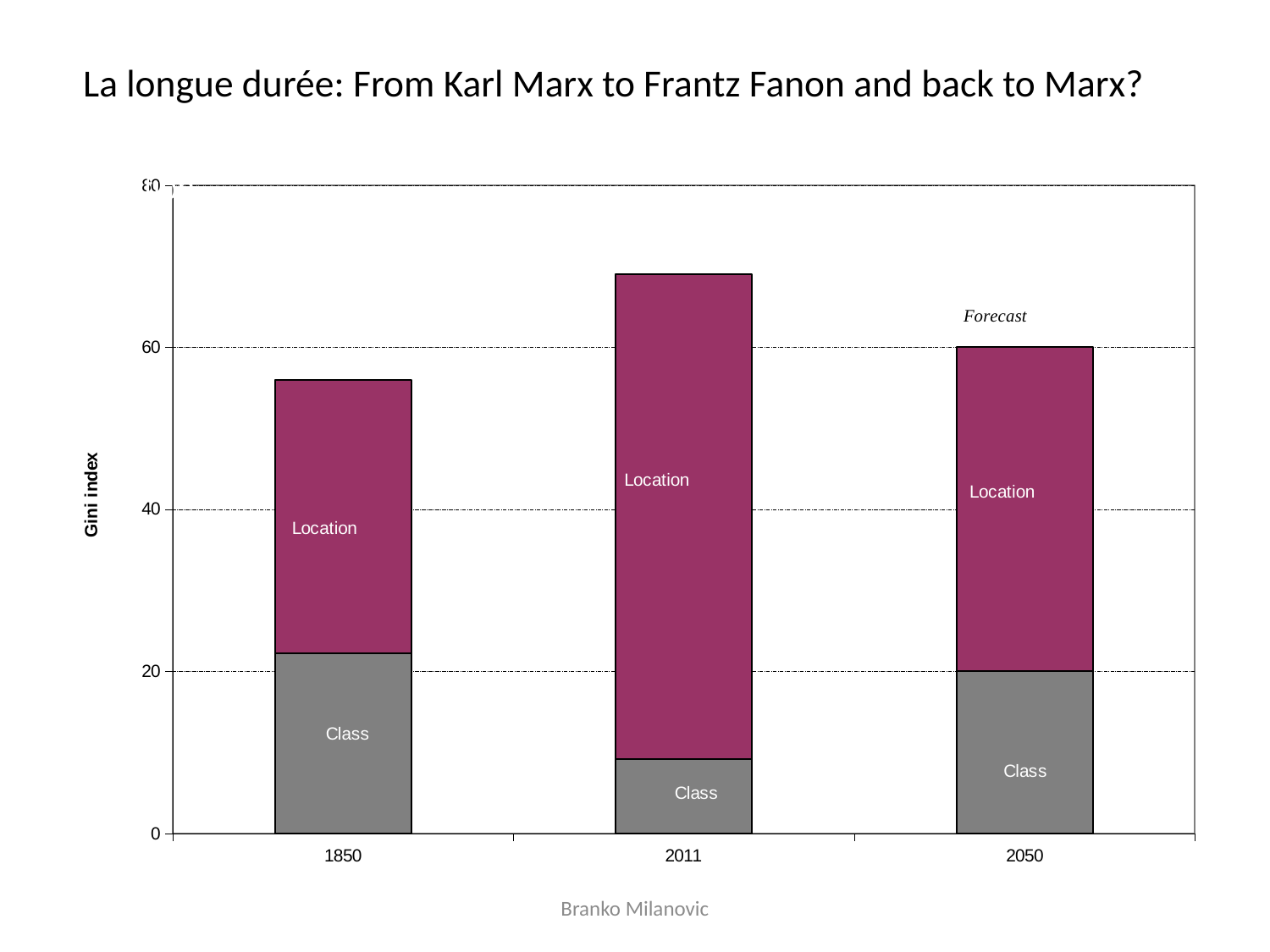
What is the label on the y axis of the chart? Gini index Is the total Gini index for 2011 greater or less than 60? greater How many components (series) is each bar split into? 2 What kind of chart is shown on the slide? bar chart Is the Location component larger in 2011 or in 2050? 2011 Which year has the highest total Gini index? 2011 Is the Class component for 2011 greater or less than 20? less Is the total Gini index for 1850 greater or less than 60? less Which year has the lowest total Gini index? 1850 Which year has the smallest Class component? 2011 How many years are shown on the x axis of the chart? 3 Which year's bar is labelled as a forecast? 2050